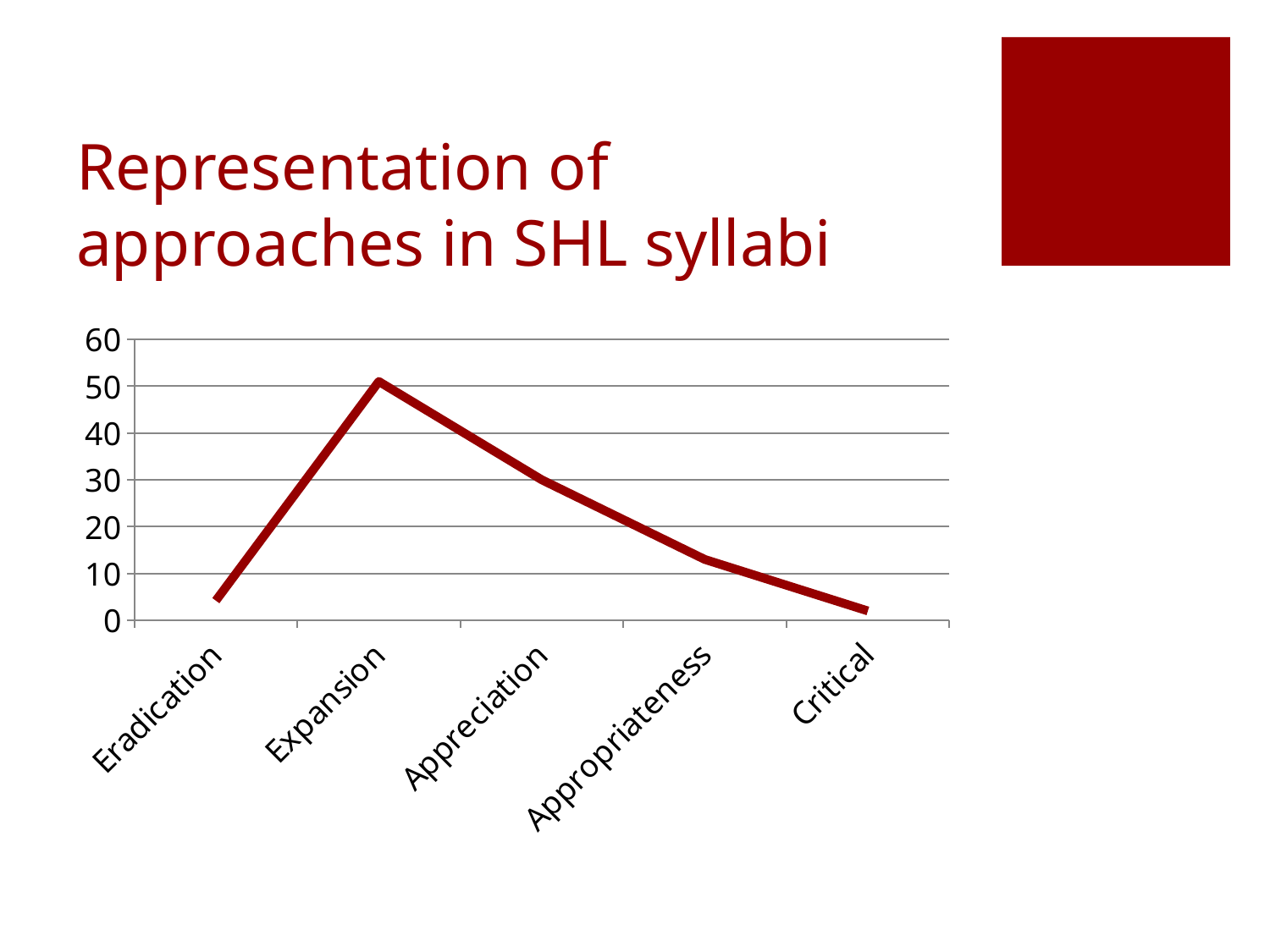
Which has the larger value, Appreciation or Appropriateness? Appreciation How many categories are plotted along the x axis? 5 Is the value for Expansion greater or less than 40? greater Which category has the highest value? Expansion Do the values rise or fall from Expansion to Critical? fall Is the value for Appropriateness greater or less than 20? less What kind of chart is shown on the slide? line chart Is the value for Critical greater or less than 10? less Which category has the lowest value? Critical What is the title of the slide containing the chart? Representation of approaches in SHL syllabi Which has the larger value, Expansion or Appreciation? Expansion